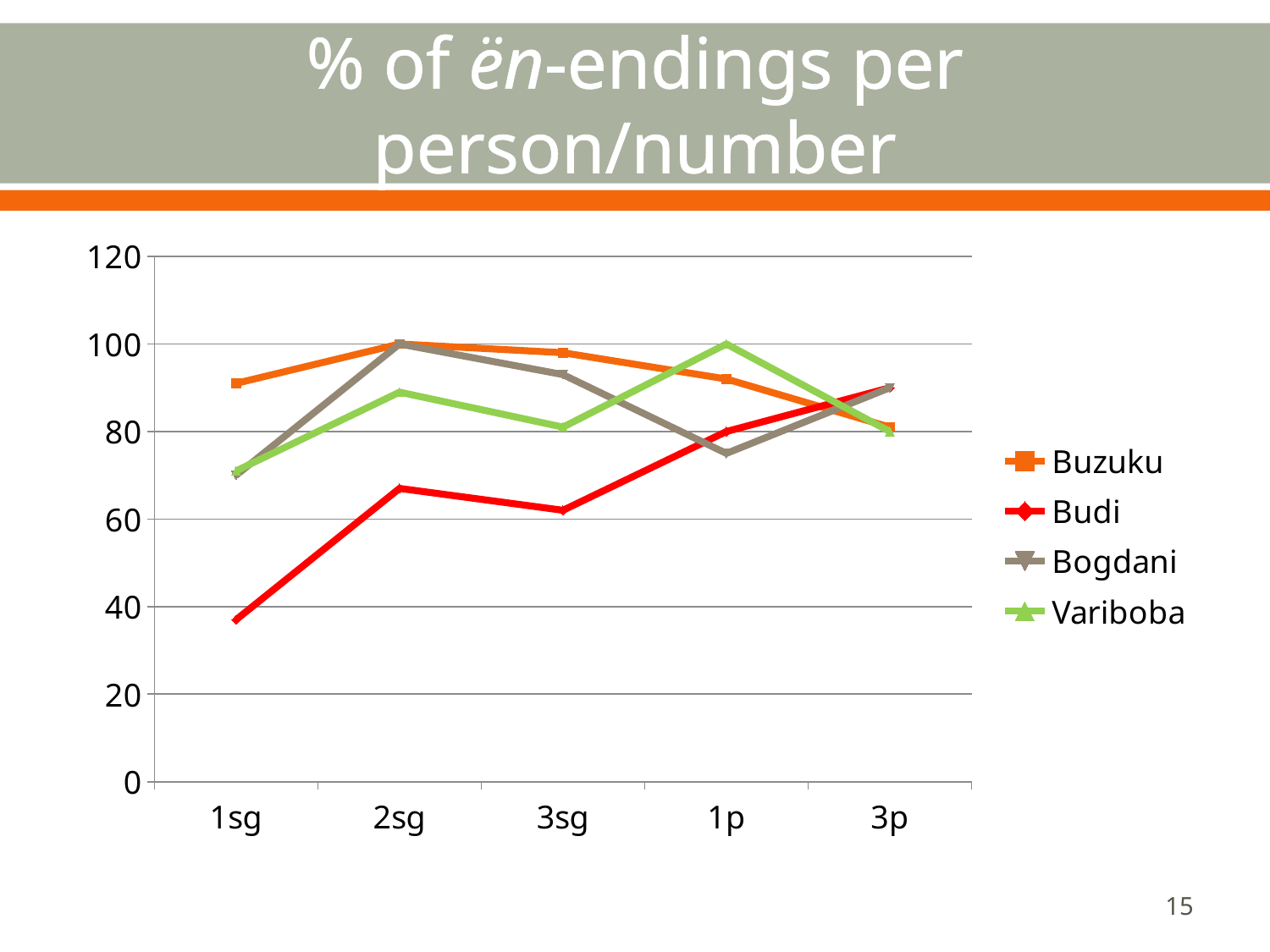
Is the value for Budi at 1sg greater or less than 40? less Which series has the lowest value at 1sg? Budi What is the value for Variboba at 1p? 100 What is the value for Bogdani at 2sg? 100 Which is larger at 3sg, Buzuku or Budi? Buzuku Is the value for Variboba at 2sg greater or less than 80? greater Is the value for Bogdani at 1p greater or less than 80? less Does the Budi line rise or fall from 1sg to 2sg? rise How many categories are shown on the x axis? 5 How many series does the legend list? 4 What kind of chart is shown on the slide? line chart